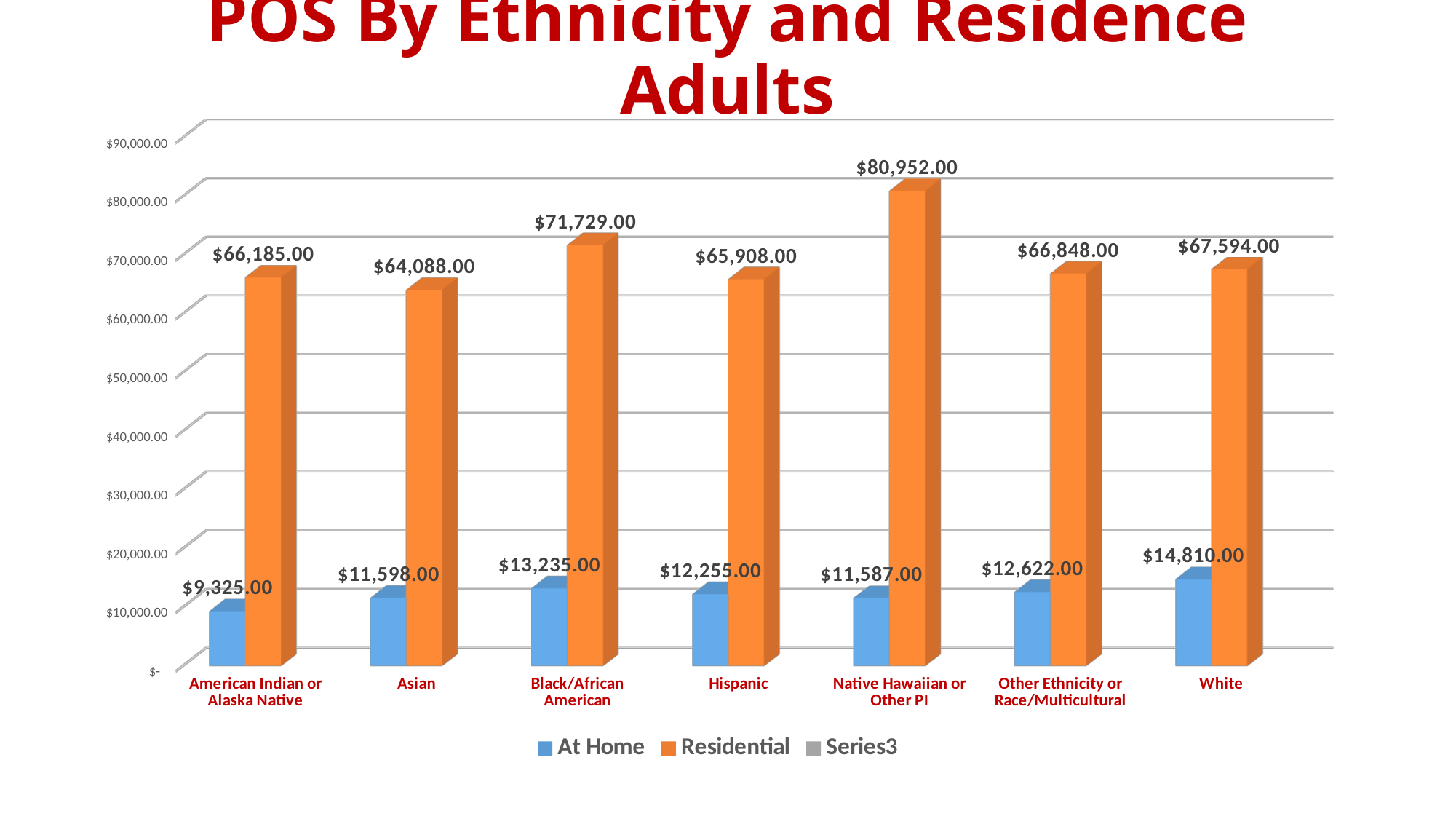
How much higher is the Residential value for Native Hawaiian or Other PI than for Black/African American? $9,223.00 How many series does the legend list? 3 What kind of chart is shown on the slide? Bar chart Which is larger, the At Home value for Black/African American or for Hispanic? Black/African American Which ethnicity has the lowest At Home value? American Indian or Alaska Native Which ethnicity has the highest Residential value? Native Hawaiian or Other PI Which ethnicity has the lowest Residential value? Asian What is the difference between the Residential and At Home values for Asian? $52,490.00 What is the At Home value for White? $14,810.00 How many ethnicity categories are shown on the x axis? 7 What is the Residential value for Hispanic? $65,908.00 Which ethnicity has the highest At Home value? White